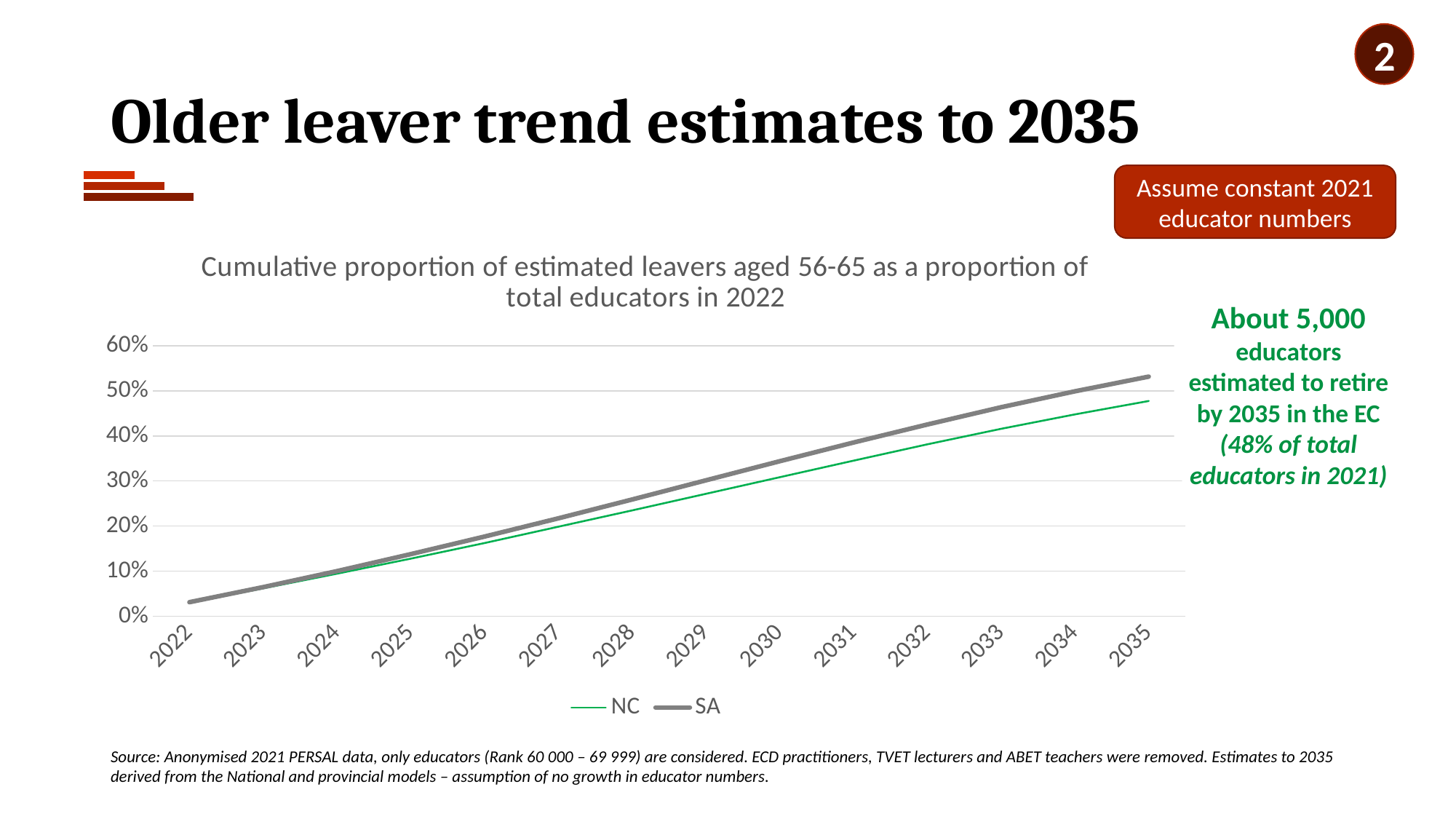
What is the title of the chart? Cumulative proportion of estimated leavers aged 56-65 as a proportion of total educators in 2022 What kind of chart is shown on the slide? line chart Which series are listed in the chart legend? NC and SA Is the value for SA in 2030 greater or less than 30%? greater Do the values for NC rise or fall from 2022 to 2035? rise Is the value for SA in 2035 greater or less than 50%? greater How many series does the chart legend list? 2 In 2035, which series has the higher value, NC or SA? SA Is the value for SA in 2022 greater or less than 10%? less How many years are shown along the x axis of the chart? 14 Do the values for SA rise or fall from 2022 to 2035? rise